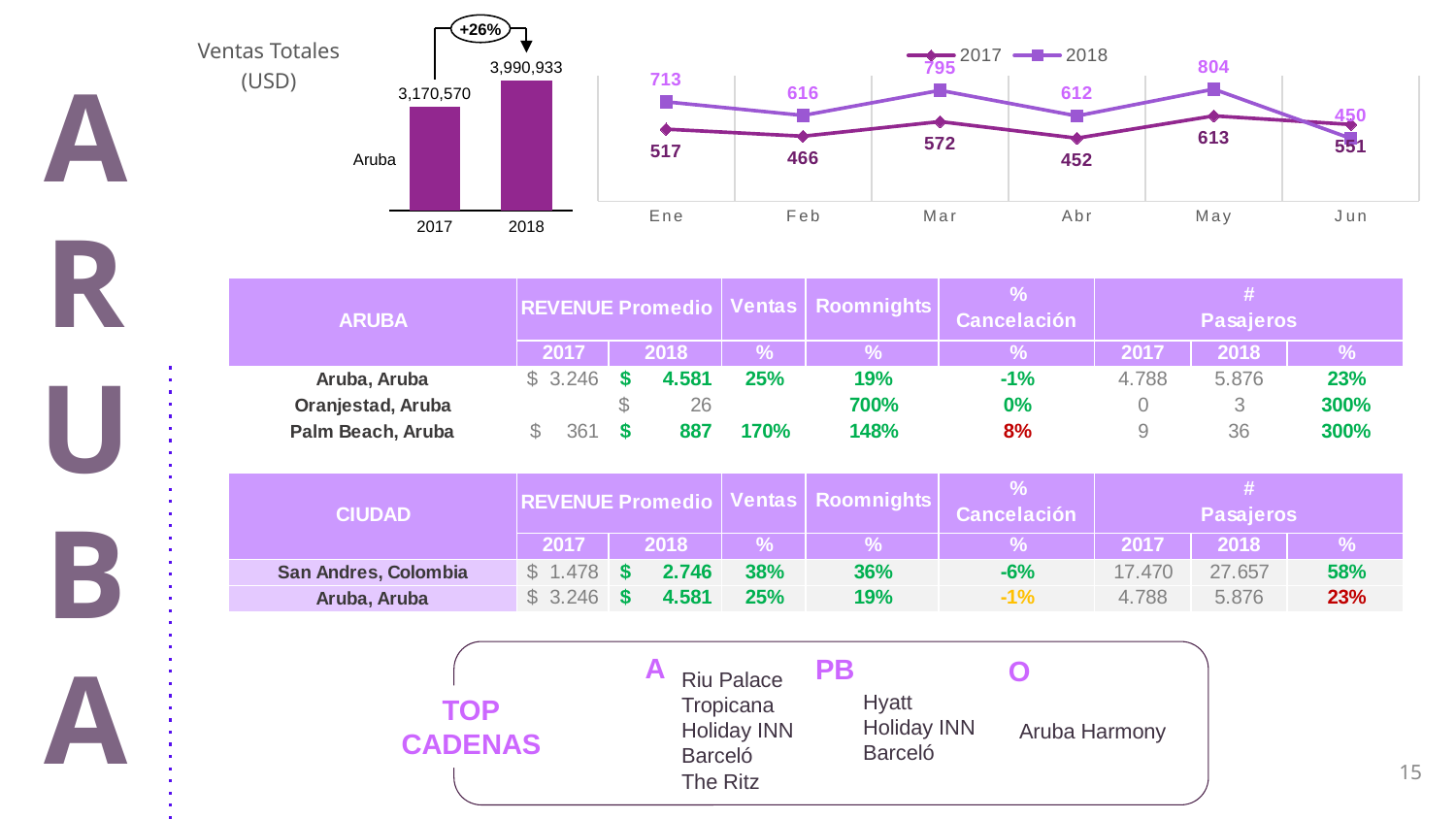
In the line chart at the top right, what is the difference between the 2018 and 2017 values for Ene? 196 In the line chart at the top right, what is the 2017 value for Abr? 452 In the line chart at the top right, what is the 2018 value for Mar? 795 In the line chart at the top right, which month has the lowest 2017 value? Abr In the line chart at the top right, which is larger for Jun, the 2017 value or the 2018 value? 2017 In the bar chart titled Ventas Totales (USD), what is the value for 2017? 3,170,570 In the bar chart titled Ventas Totales (USD), what is the difference between the 2018 and 2017 values? 820,363 In the bar chart titled Ventas Totales (USD), what is the value for 2018? 3,990,933 What kind of chart is the one at the top right showing monthly values from Ene to Jun? line chart In the line chart at the top right, which month has the highest 2018 value? May How many series does the legend of the line chart at the top right list? 2 In the bar chart titled Ventas Totales (USD), what percentage change is annotated between 2017 and 2018? +26%